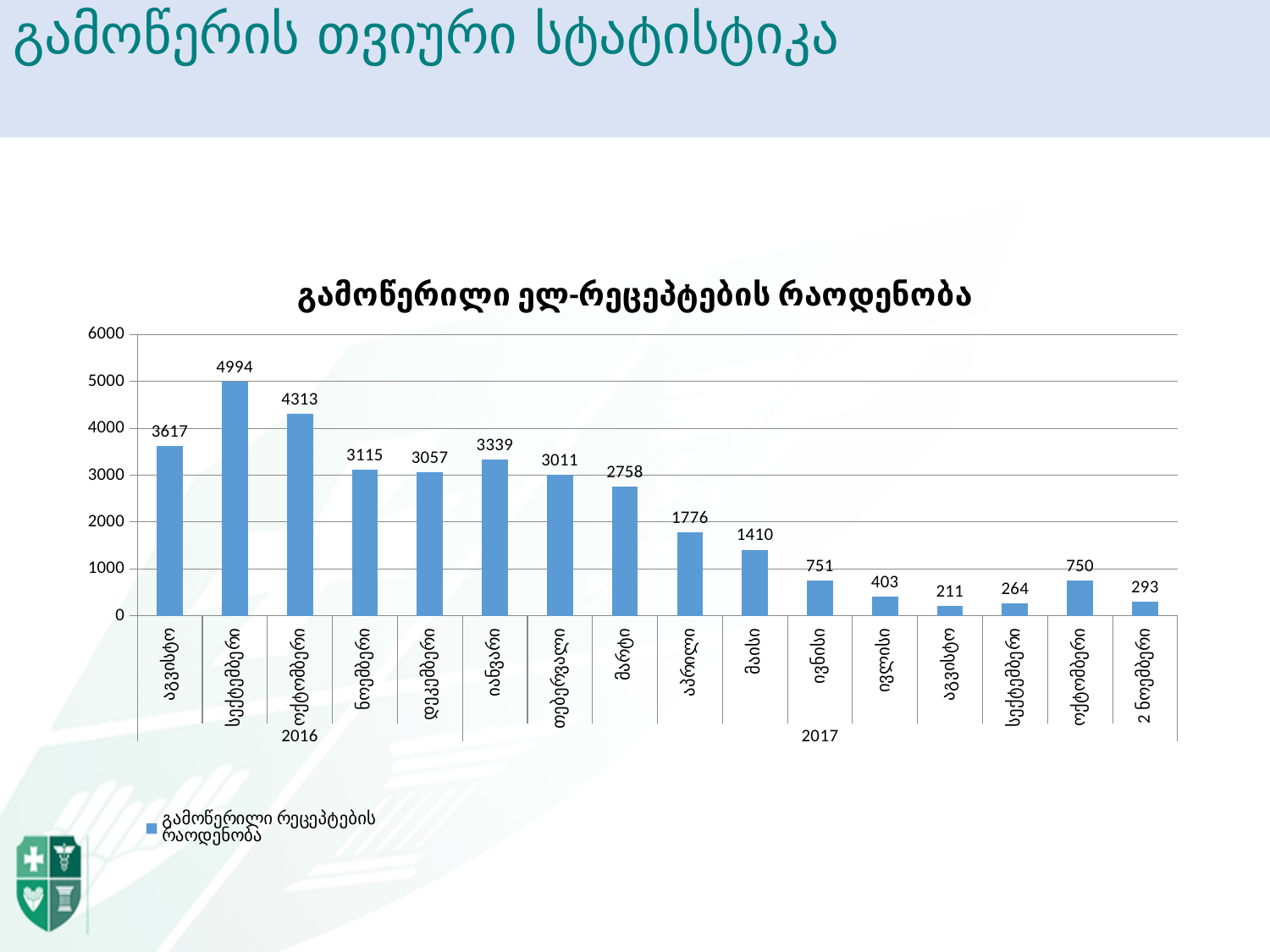
Which is larger, the value for იანვარი 2017 or the value for თებერვალი 2017? იანვარი 2017 What is the value for 2 ნოემბერი 2017? 293 What is the title of the chart? გამოწერილი ელ-რეცეპტების რაოდენობა What is the difference between the values for სექტემბერი 2016 and ოქტომბერი 2016? 681 Is the value for აპრილი 2017 greater or less than 2000? less What is the value for მაისი 2017? 1410 Which month has the highest value? სექტემბერი 2016 What type of chart is shown on the slide? bar chart How many months (bars) are shown in the chart? 16 What is the value for სექტემბერი 2016? 4994 Which month has the lowest value? აგვისტო 2017 How many series does the legend list? 1